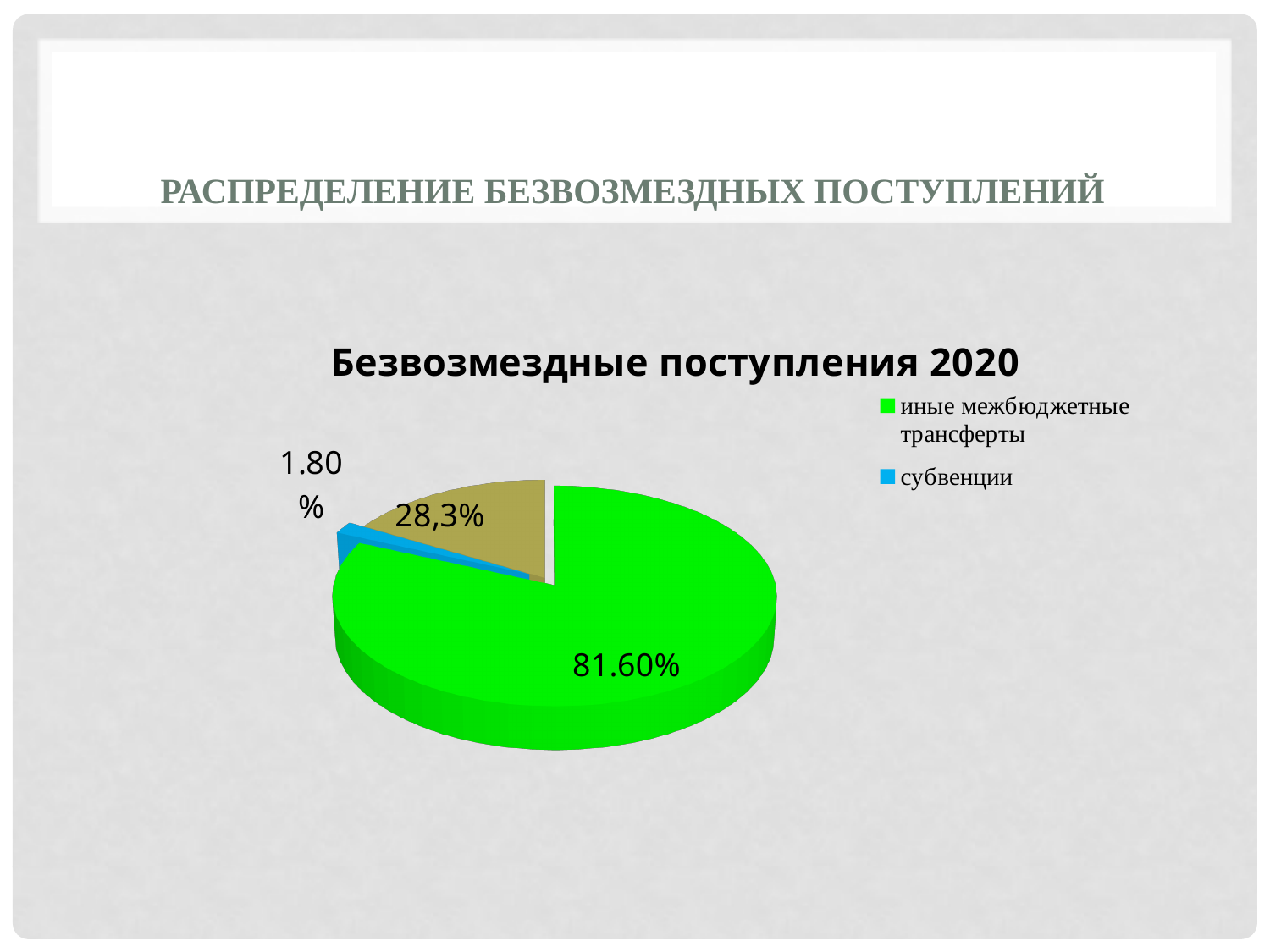
What share of the pie is labelled for иные межбюджетные трансферты? 81.60% Which legend category has the smallest slice of the pie? субвенции What value is printed on the tan-coloured slice of the pie? 28,3% What value is shown for субвенции? 1.80% What kind of chart is shown on the slide? pie chart Which legend category has the largest slice of the pie? иные межбюджетные трансферты How many slices does the pie chart have? 3 What is the difference between the value for иные межбюджетные трансферты and the value for субвенции? 79.80% What colour is the slice for субвенции? blue Which is larger: the slice for иные межбюджетные трансферты or the slice for субвенции? иные межбюджетные трансферты How many entries does the chart legend list? 2 What is the title of the chart? Безвозмездные поступления 2020